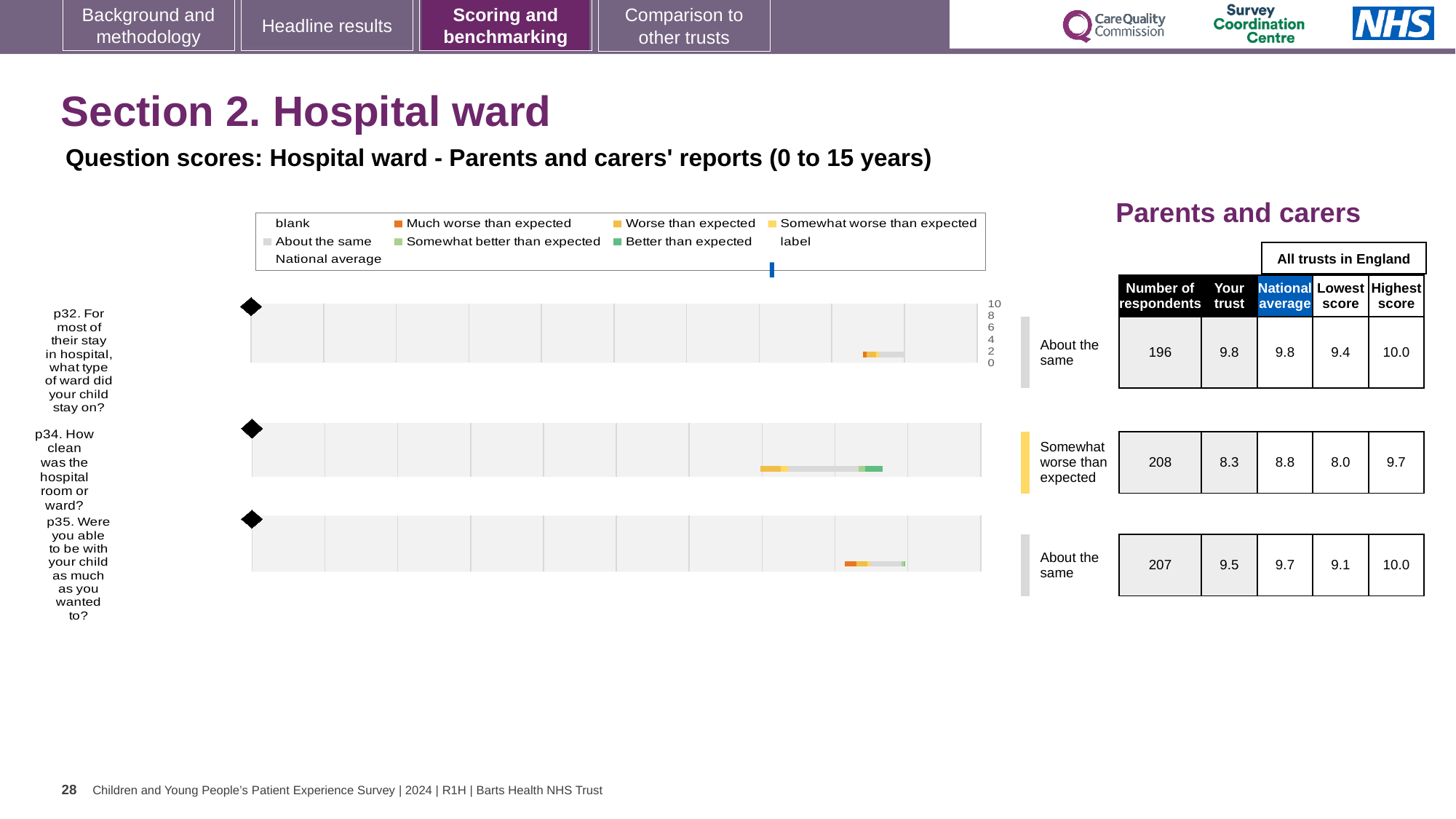
How many respondents answered p32 'For most of their stay in hospital, what type of ward did your child stay on?' 196 Which question has the highest 'Your trust' score? p32. For most of their stay in hospital, what type of ward did your child stay on? How many questions are plotted on this slide? 3 What benchmark category is shown for p34 'How clean was the hospital room or ward?' Somewhat worse than expected For p32, what is the difference between the highest score and the lowest score among all trusts in England? 0.6 For p35 'Were you able to be with your child as much as you wanted to?', which is larger: the 'Your trust' score or the national average? National average Which question has the lowest 'Your trust' score? p34. How clean was the hospital room or ward? What is the highest score among all trusts in England for p34 'How clean was the hospital room or ward?' 9.7 What is the national average score for p35 'Were you able to be with your child as much as you wanted to?' 9.7 For p34 'How clean was the hospital room or ward?', what is the difference between the national average and the 'Your trust' score? 0.5 What kind of chart is used to show the question scores? Bar chart What is the 'Your trust' score for p34 'How clean was the hospital room or ward?' 8.3